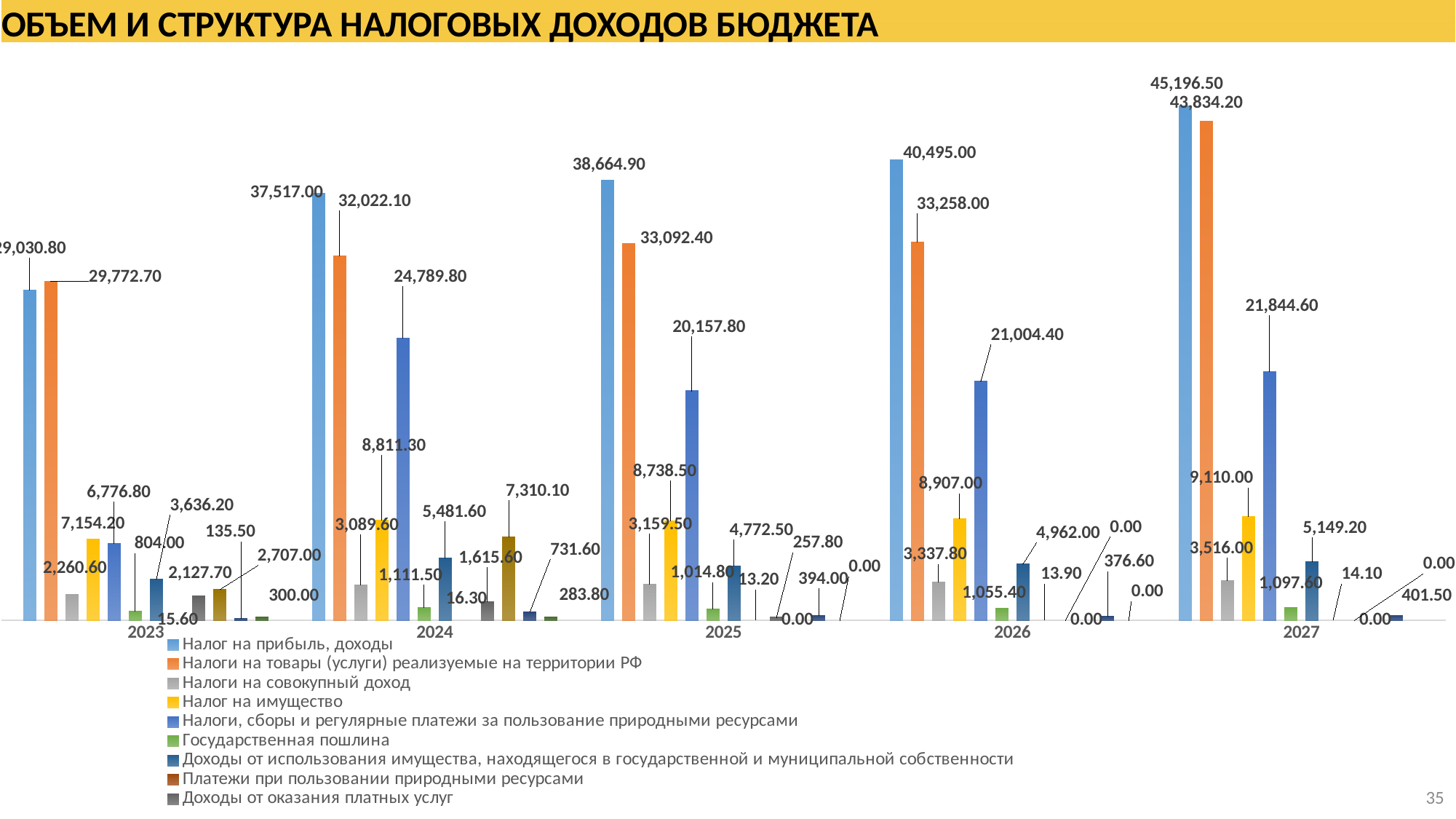
In which year is 'Налоги на совокупный доход' lowest? 2023 What is the title of the slide's chart? ОБЪЕМ И СТРУКТУРА НАЛОГОВЫХ ДОХОДОВ БЮДЖЕТА What is the value of 'Налоги на товары (услуги) реализуемые на территории РФ' for 2025? 33,092.40 How many series does the legend list? 9 What is the value of 'Налоги, сборы и регулярные платежи за пользование природными ресурсами' for 2024? 24,789.80 How many years are shown along the x axis of the chart? 5 Does 'Налог на прибыль, доходы' rise or fall from 2023 to 2027? rise What is the difference between 'Налог на прибыль, доходы' and 'Налоги на товары (услуги) реализуемые на территории РФ' in 2027? 1,362.30 What kind of chart is shown on the slide? bar chart What is the value of 'Налог на имущество' for 2026? 8,907.00 In which year is 'Налог на прибыль, доходы' highest? 2027 What is the value of 'Налог на прибыль, доходы' for 2027? 45,196.50